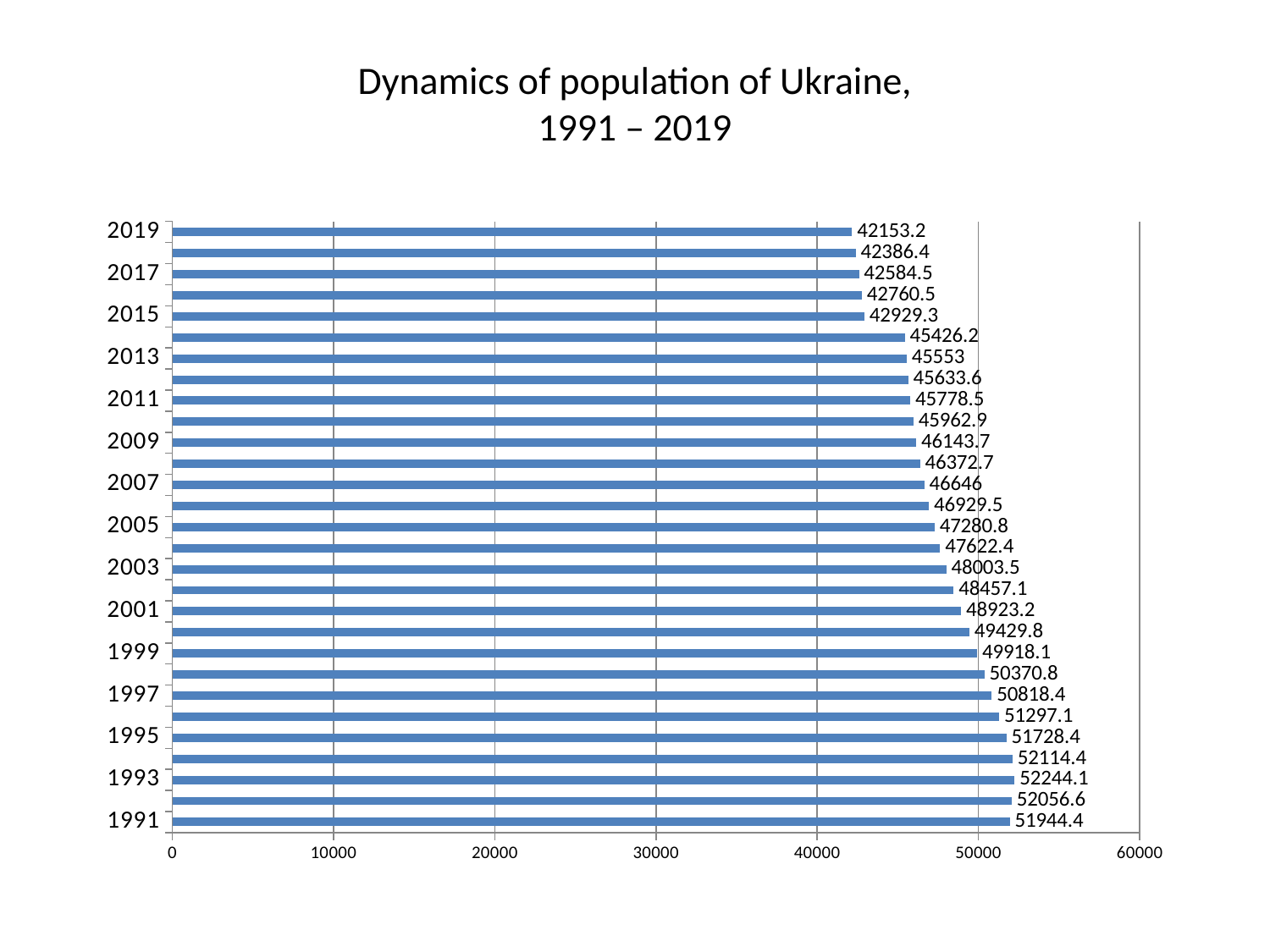
What is the difference between the population values for 1991 and 2019? 9791.2 What kind of chart is shown on the slide? Bar chart What is the population value shown for 2019? 42153.2 Which year has the lowest population value? 2019 Do the population values rise or fall from 1993 to 2019? Fall What is the population value shown for 2013? 45553 Which is larger, the population value for 1997 or for 2005? 1997 What is the population value shown for 1991? 51944.4 Which year has the highest population value? 1993 What is the difference between the population values for 2013 and 2015? 2623.7 What is the population value shown for 2007? 46646 How many bars are plotted in the chart? 29